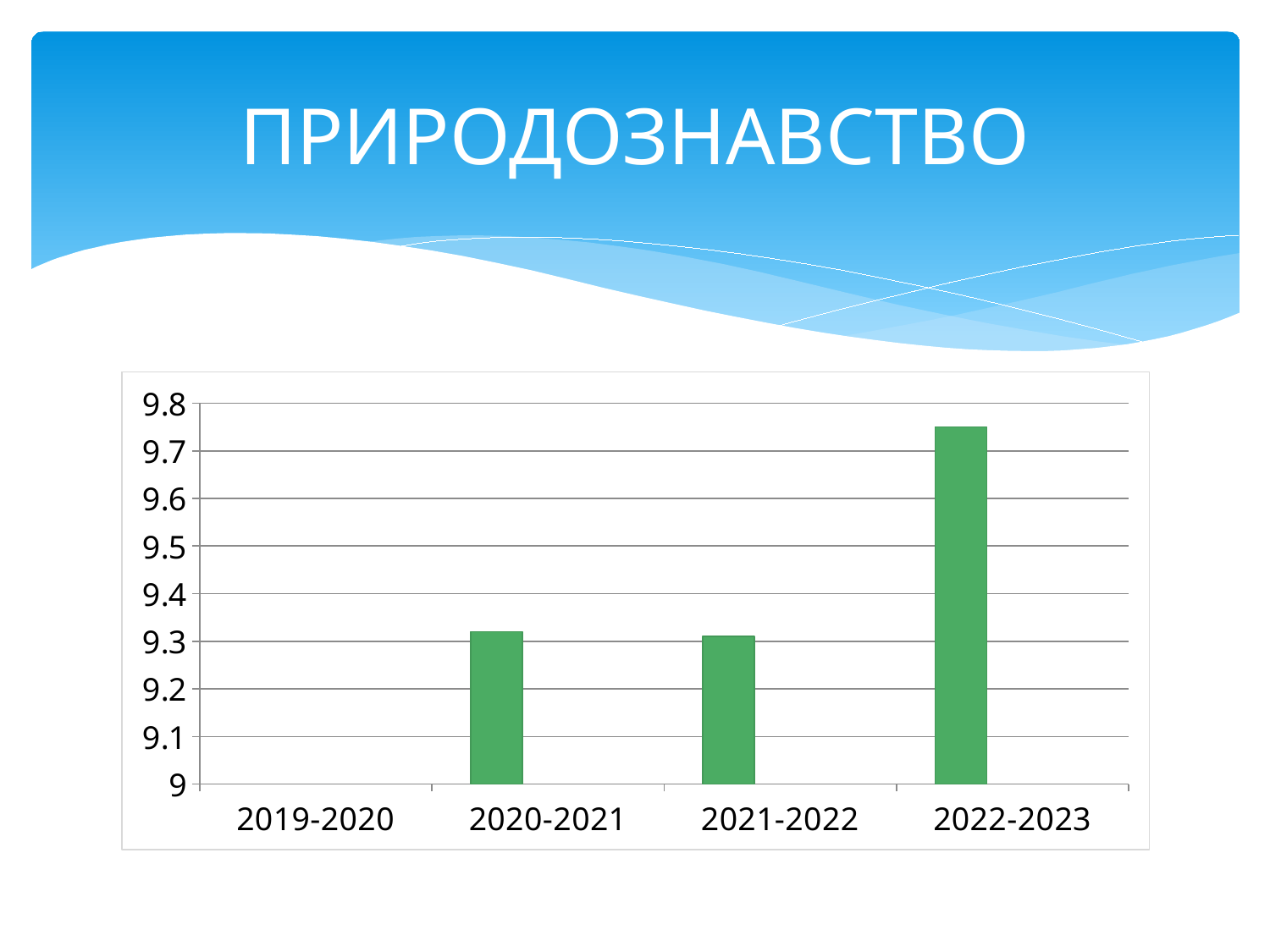
Is the value for 2022-2023 greater or less than 9.7? greater How many categories are shown on the x axis of the chart? 4 Is the value for 2021-2022 greater or less than 9.2? greater Does the value rise or fall from 2021-2022 to 2022-2023? rise Is the value for 2022-2023 greater or less than 9.8? less Which category has the highest bar in the chart? 2022-2023 What is the title shown above the chart on the slide? ПРИРОДОЗНАВСТВО Which category on the x axis has no visible bar? 2019-2020 Which is larger, the value for 2021-2022 or the value for 2022-2023? 2022-2023 Which is larger, the value for 2022-2023 or the value for 2020-2021? 2022-2023 What kind of chart is shown on the slide? bar chart